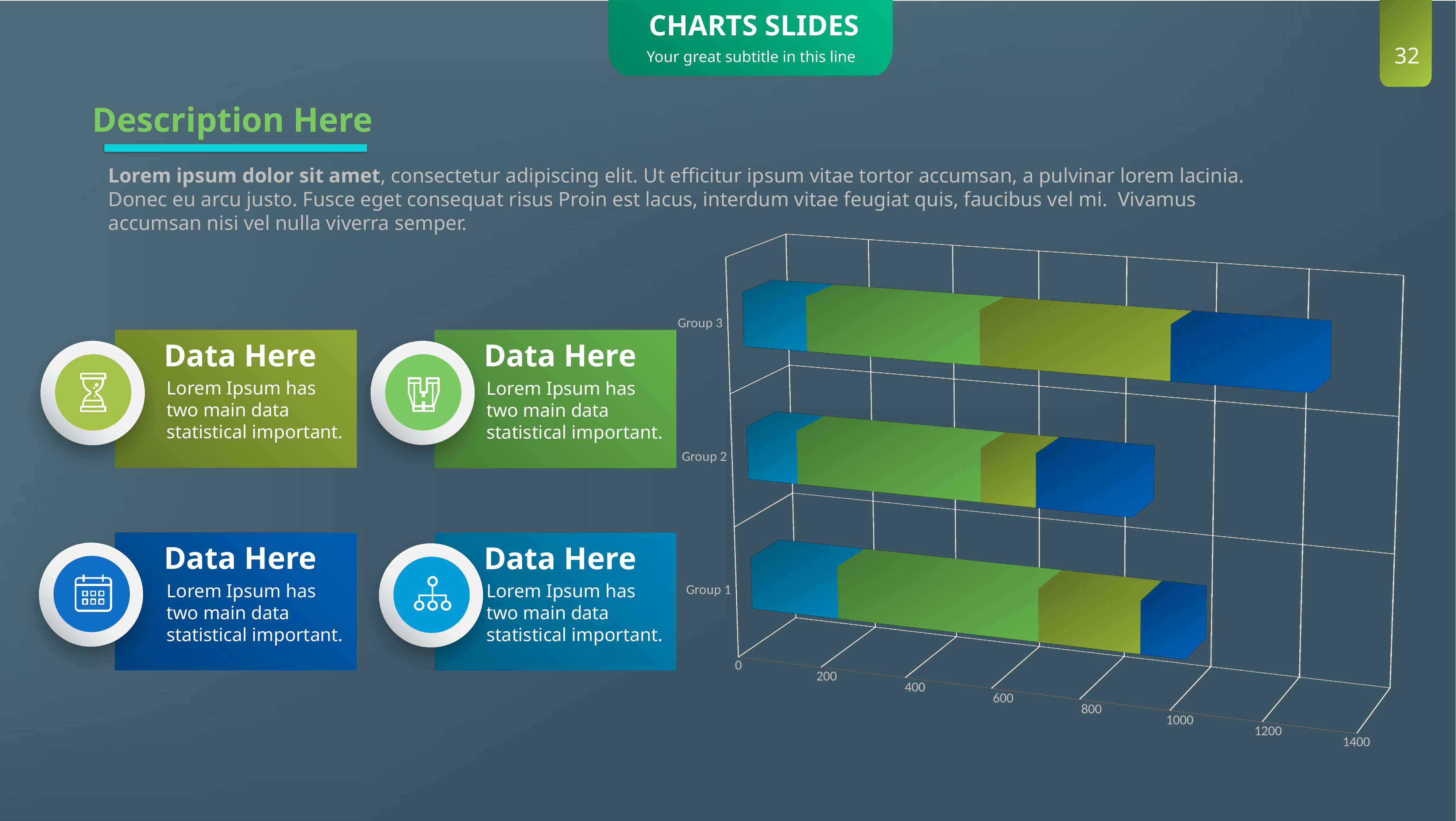
Is the total value for Group 2 greater or less than 1200? less What is the highest tick value shown on the chart's value axis? 1400 Which bar is longer, Group 3 or Group 2? Group 3 What kind of chart is shown on the slide? bar chart How many groups (categories) are plotted on the chart? 3 Which group has the longest bar on the chart? Group 3 Is the total value for Group 3 greater or less than 1000? greater Is the total value for Group 2 greater or less than 600? greater Which bar is longer, Group 3 or Group 1? Group 3 How many coloured segments make up each stacked bar on the chart? 4